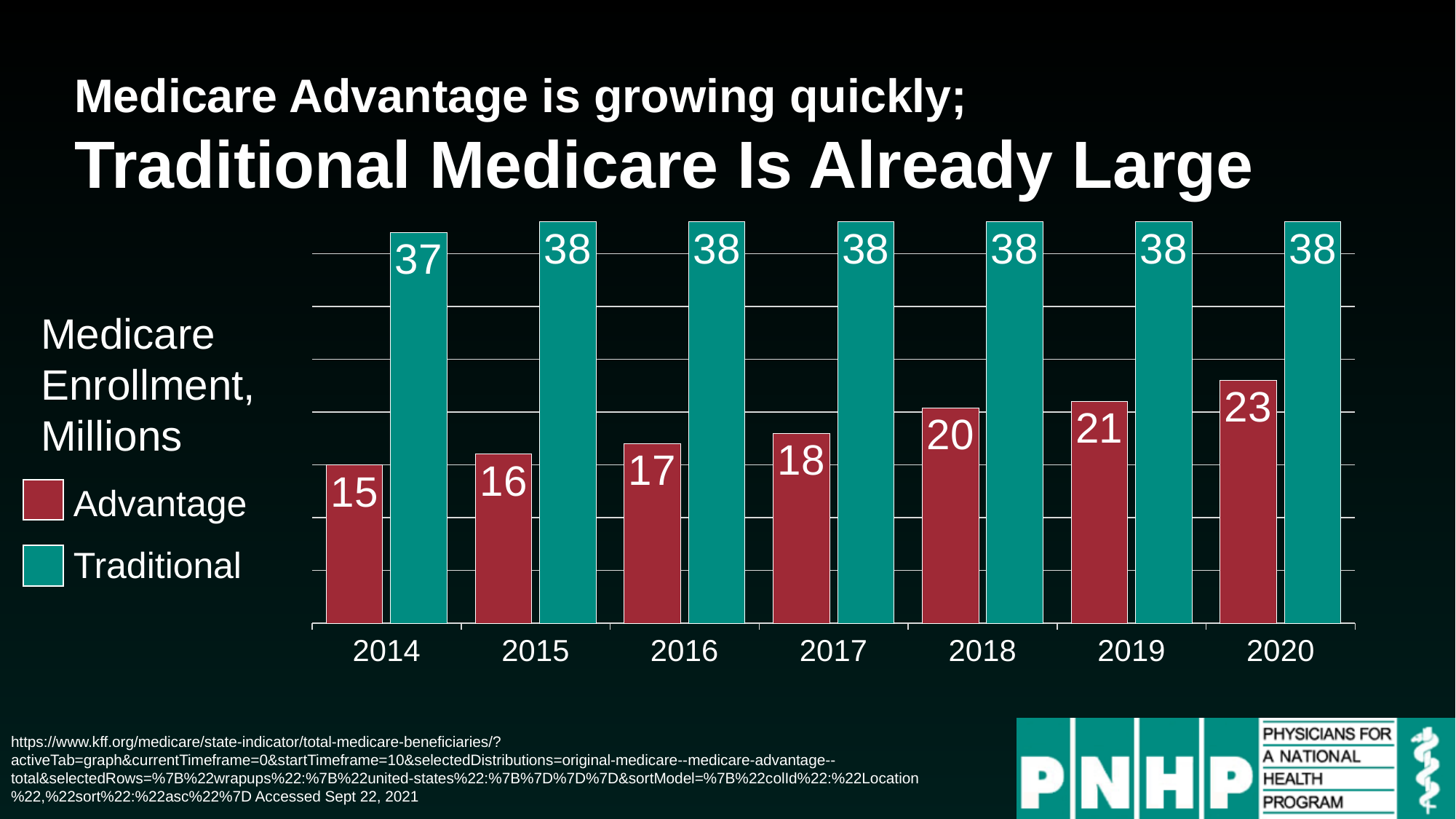
What kind of chart is shown on the slide? Bar chart Does Advantage enrollment rise or fall from 2014 to 2020? Rise What is the Advantage enrollment value for 2014? 15 How many series does the legend list? 2 Which is larger in 2017, Advantage or Traditional enrollment? Traditional What is the Advantage enrollment value for 2018? 20 What is the difference between Advantage enrollment in 2020 and in 2014? 8 Which year has the highest Advantage enrollment? 2020 What is the Traditional enrollment value for 2020? 38 What is the difference between Traditional and Advantage enrollment in 2020? 15 How many years are shown on the x axis? 7 Which year has the lowest Advantage enrollment? 2014